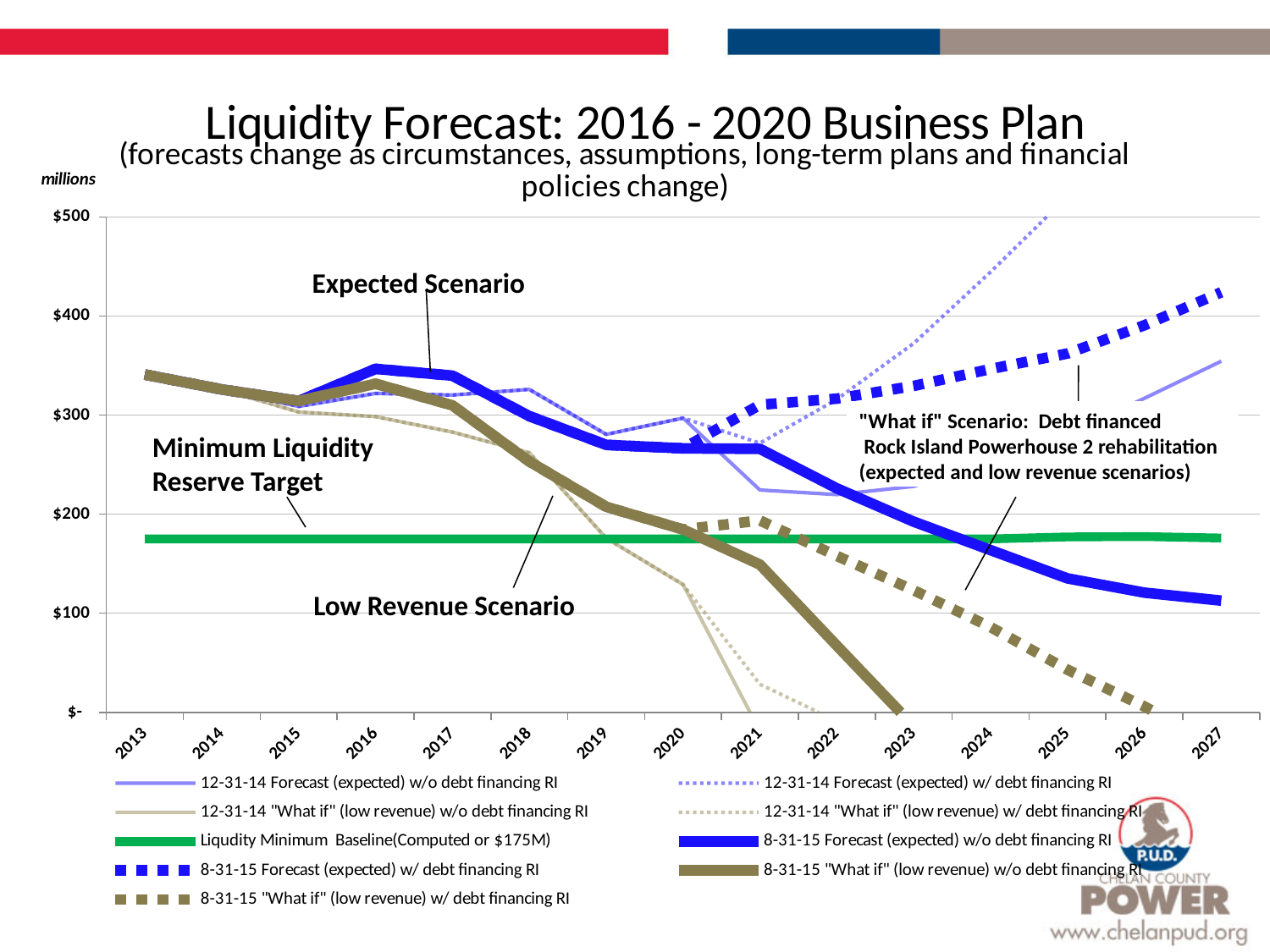
What is the title of the chart? Liquidity Forecast: 2016 - 2020 Business Plan What kind of chart is shown on the slide? line chart Is the value of the 8-31-15 "What if" (low revenue) w/o debt financing RI line in 2016 greater or less than $300? greater In 2027, which is larger: the 8-31-15 Forecast (expected) w/ debt financing RI line or the 8-31-15 Forecast (expected) w/o debt financing RI line? 8-31-15 Forecast (expected) w/ debt financing RI Is the Liquidity Minimum Baseline line greater or less than $200 across the chart? less Does the 8-31-15 "What if" (low revenue) w/o debt financing RI line rise or fall from 2013 to 2023? fall Is the value of the 8-31-15 "What if" (low revenue) w/ debt financing RI line in 2026 greater or less than $100? less How many series does the chart's legend list? 9 Does the 8-31-15 Forecast (expected) w/ debt financing RI line rise or fall from 2021 to 2027? rise How many years are shown along the x axis of the chart? 15